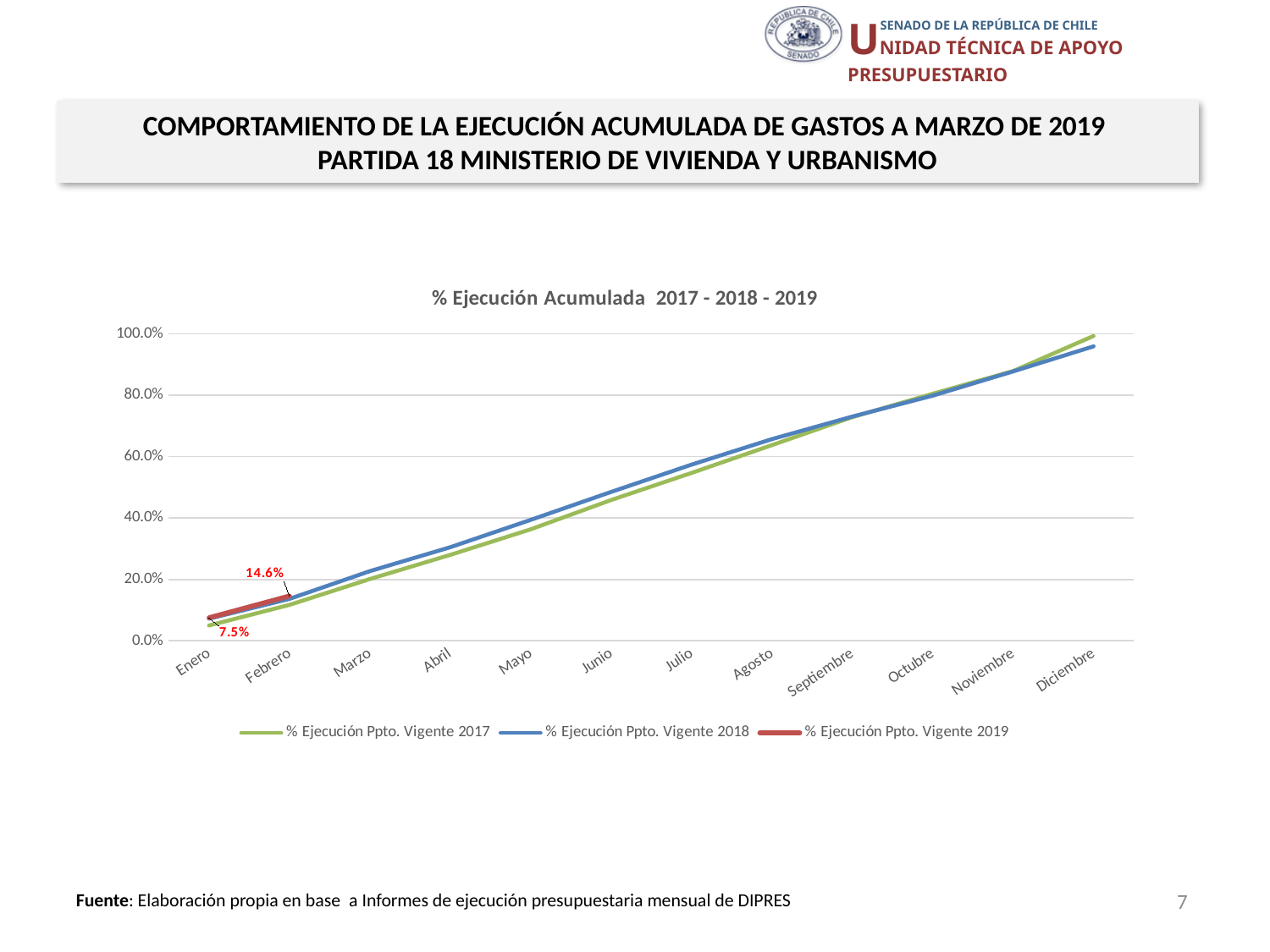
Is the value for % Ejecución Ppto. Vigente 2017 in Diciembre greater or less than 80%? greater What colour is the line for % Ejecución Ppto. Vigente 2019? red Do the values for % Ejecución Ppto. Vigente 2018 rise or fall from Enero to Diciembre? rise What kind of chart is shown on the slide? line chart What is the title of the chart? % Ejecución Acumulada 2017 - 2018 - 2019 What is the value for % Ejecución Ppto. Vigente 2019 in Febrero? 14.6% What is the value for % Ejecución Ppto. Vigente 2019 in Enero? 7.5% What is the difference between the Febrero and Enero values for % Ejecución Ppto. Vigente 2019? 7.1% How many months are shown on the x axis? 12 Is the value for % Ejecución Ppto. Vigente 2018 in Junio greater or less than 60%? less How many series does the legend list? 3 Which is larger for % Ejecución Ppto. Vigente 2019: the Enero value or the Febrero value? Febrero